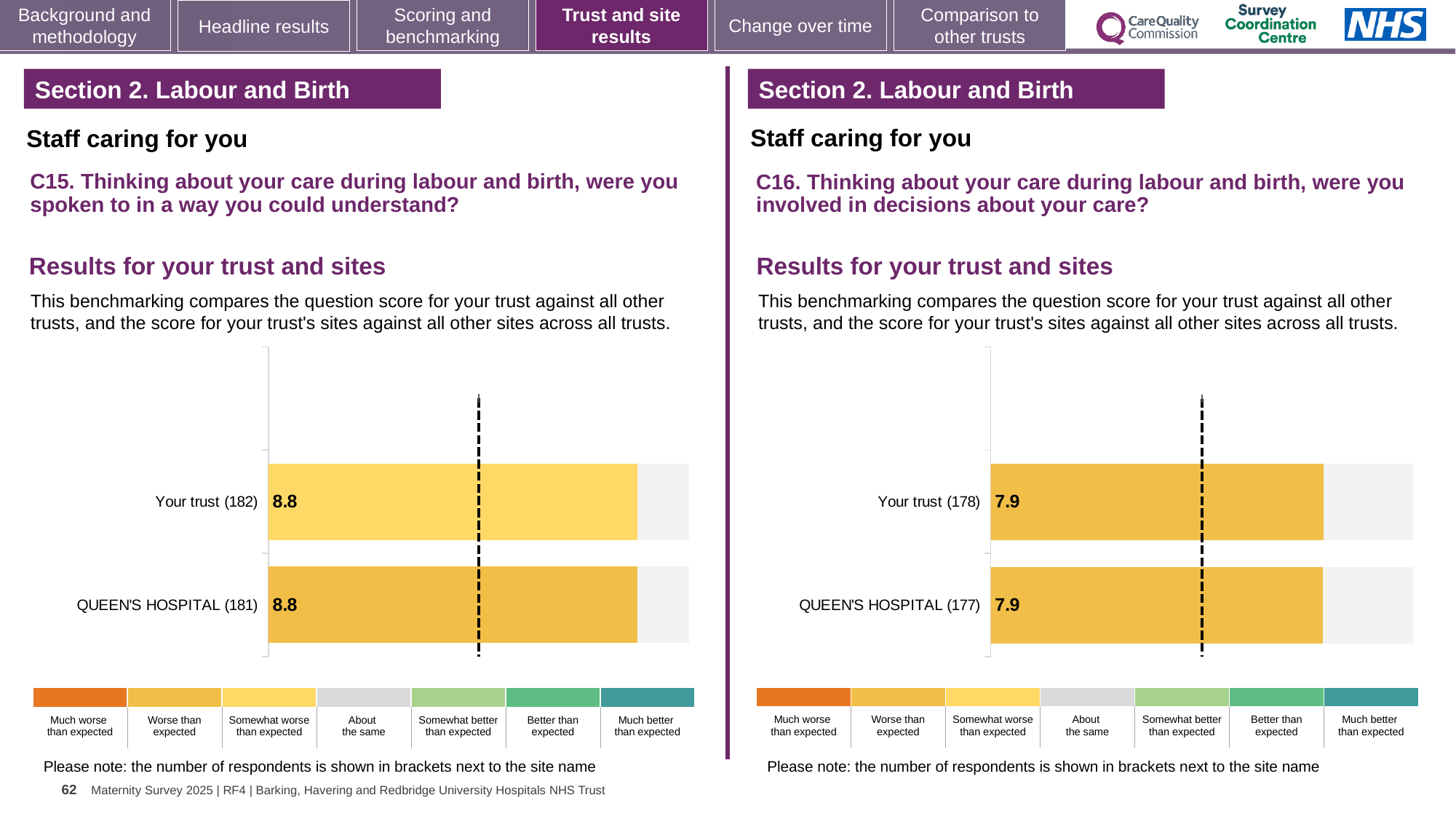
On the C15 chart (left), how many respondents are shown in brackets for Your trust? 182 How many bars are plotted on the C15 chart (left)? 2 On the C16 chart (right), what is the difference between the Your trust score and the QUEEN'S HOSPITAL score? 0 On the C16 chart (right), what is the score for Your trust? 7.9 On the C15 chart (left), what is the difference between the Your trust score and the QUEEN'S HOSPITAL score? 0 Is the Your trust score on the C15 chart (left) larger or smaller than the Your trust score on the C16 chart (right)? Larger How many bars are plotted on the C16 chart (right)? 2 What kind of chart is used on the C15 chart (left)? Bar chart On the C15 chart (left), what is the score for Your trust? 8.8 On the C15 chart (left), what is the score for QUEEN'S HOSPITAL? 8.8 On the C16 chart (right), what is the score for QUEEN'S HOSPITAL? 7.9 On the C16 chart (right), how many respondents are shown in brackets for QUEEN'S HOSPITAL? 177